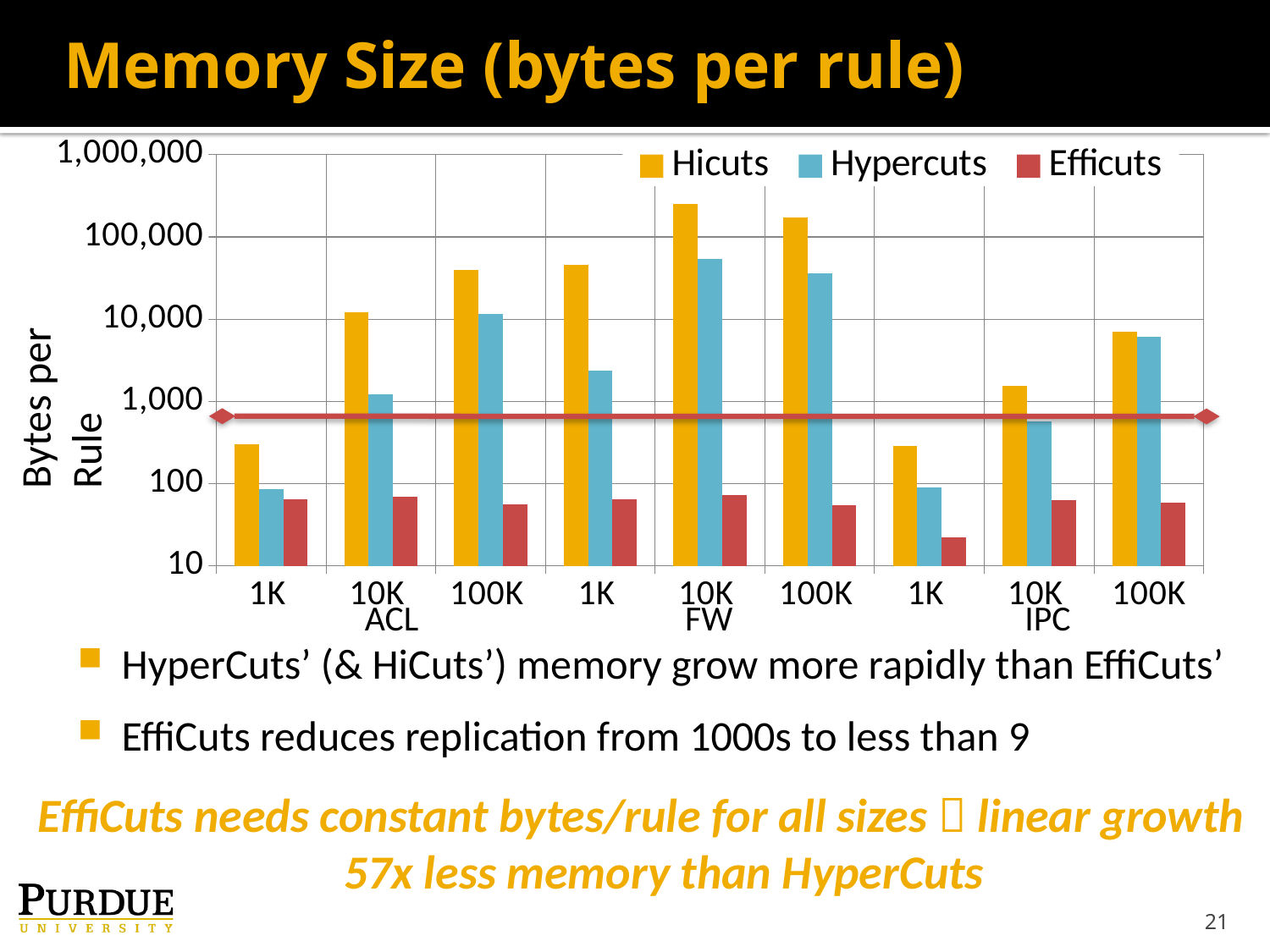
Is the Hypercuts value for FW 10K greater or less than 10,000? greater Is the Efficuts value for ACL 1K greater or less than 100? less For FW 100K, which is larger, the Hicuts bar or the Hypercuts bar? Hicuts Is the Hicuts value for FW 10K greater or less than 100,000? greater Which series has the highest bar anywhere on the chart? Hicuts How many series does the legend list? 3 How many category groups are shown along the x axis? 9 What colour represents Efficuts in the legend? red What kind of chart is shown on the slide? bar chart Which series has the lowest bar anywhere on the chart? Efficuts Do the Hicuts values rise or fall from ACL 1K to ACL 100K? rise